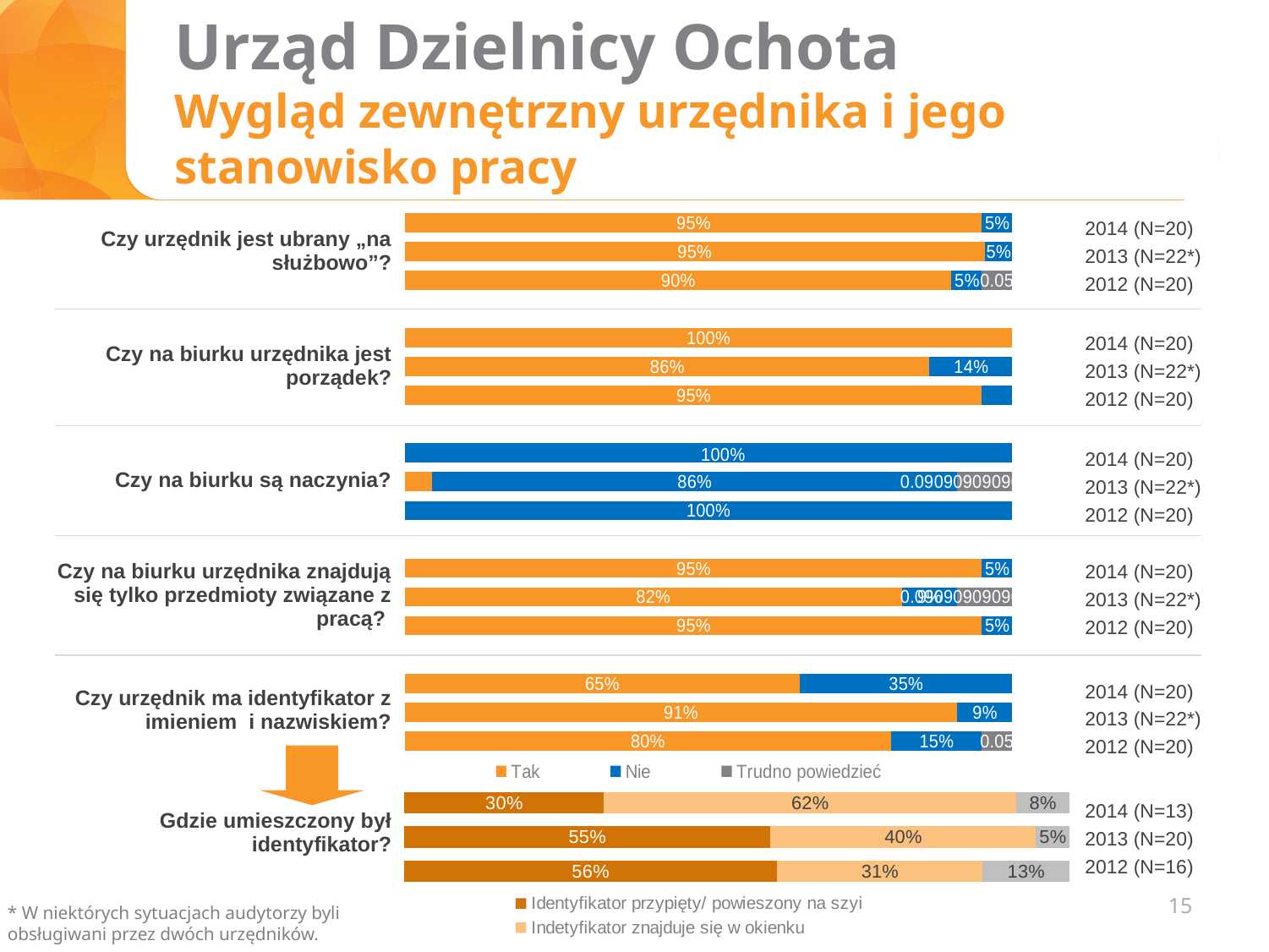
In the chart "Gdzie umieszczony był identyfikator?", is the "Identyfikator przypięty/ powieszony na szyi" value larger in 2012 (N=16) or in 2014 (N=13)? 2012 (N=16) In the chart "Czy urzędnik ma identyfikator z imieniem i nazwiskiem?", which year has the lowest "Tak" value? 2014 (N=20) In the chart "Czy urzędnik ma identyfikator z imieniem i nazwiskiem?", what is the difference between the "Tak" values for 2013 (N=22*) and 2014 (N=20)? 26% What type of chart is used for "Gdzie umieszczony był identyfikator?"? Stacked bar chart In the chart "Gdzie umieszczony był identyfikator?", what is the value for "Identyfikator przypięty/ powieszony na szyi" in 2013 (N=20)? 55% In the chart "Czy na biurku urzędnika jest porządek?", what is the "Nie" value for 2013 (N=22*)? 14% In the chart "Gdzie umieszczony był identyfikator?", what is the value for "Indetyfikator znajduje się w okienku" in 2014 (N=13)? 62% In the chart "Czy urzędnik jest ubrany „na służbowo"?", what is the "Tak" value for 2012 (N=20)? 90% In the chart "Czy urzędnik ma identyfikator z imieniem i nazwiskiem?", which year has the highest "Tak" value? 2013 (N=22*) In the chart "Czy urzędnik ma identyfikator z imieniem i nazwiskiem?", what is the "Tak" value for 2014 (N=20)? 65% In the chart "Czy urzędnik ma identyfikator z imieniem i nazwiskiem?", what is the "Nie" value for 2013 (N=22*)? 9% How many series does the legend of the chart "Czy urzędnik ma identyfikator z imieniem i nazwiskiem?" list? 3